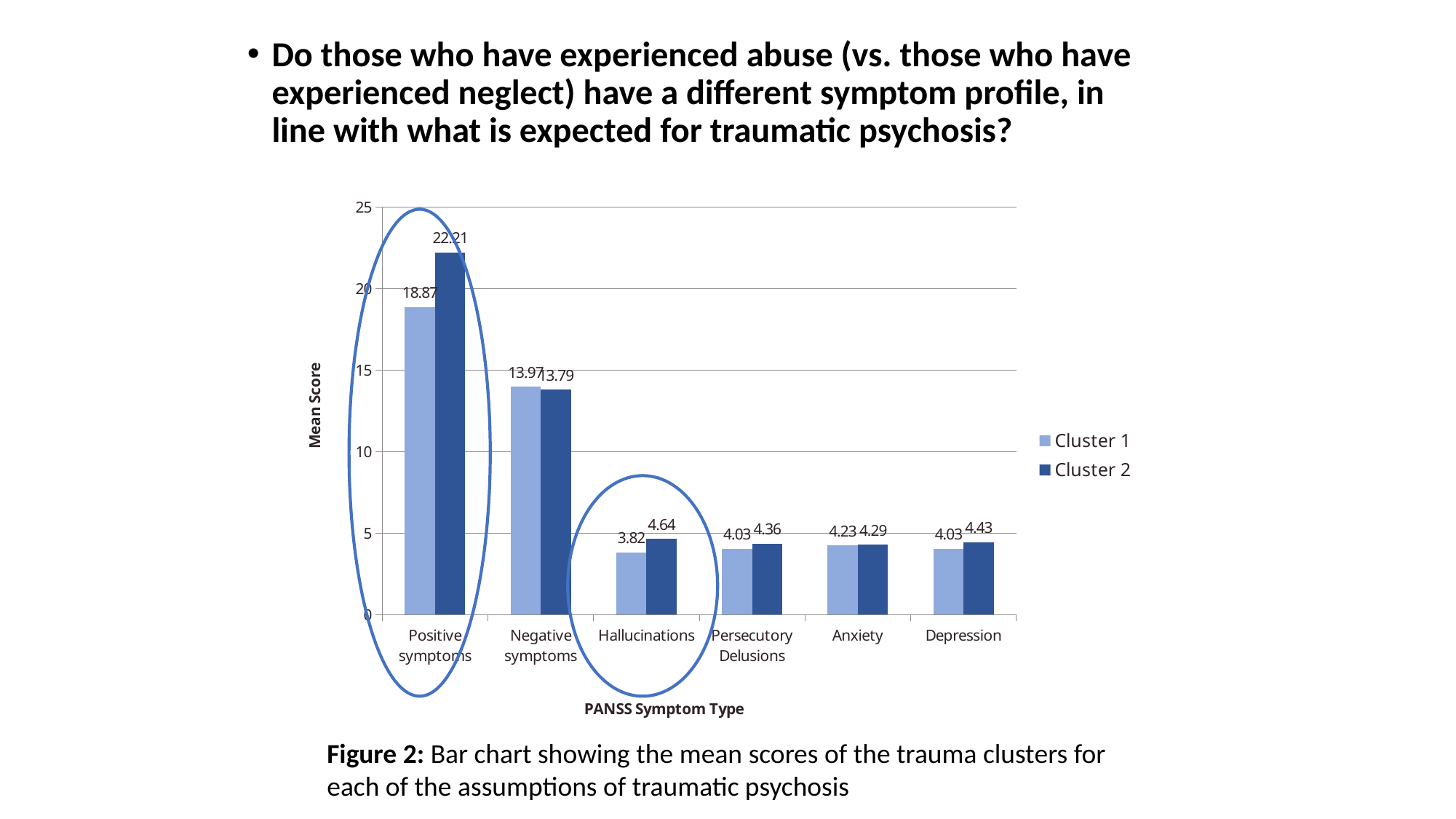
What is the Cluster 1 mean score for Hallucinations? 3.82 Which cluster has the larger mean score for Negative symptoms? Cluster 1 What is the difference between the Cluster 2 and Cluster 1 mean scores for Positive symptoms? 3.34 Which symptom type has the lowest Cluster 2 mean score? Anxiety How many PANSS symptom types are shown on the x axis? 6 What is the label of the y axis? Mean Score Is the Cluster 1 mean score for Positive symptoms greater or less than 20? less How many series does the legend list? 2 Which symptom type has the highest Cluster 1 mean score? Positive symptoms What is the Cluster 1 mean score for Negative symptoms? 13.97 What is the Cluster 2 mean score for Positive symptoms? 22.21 What kind of chart is shown on the slide? Bar chart